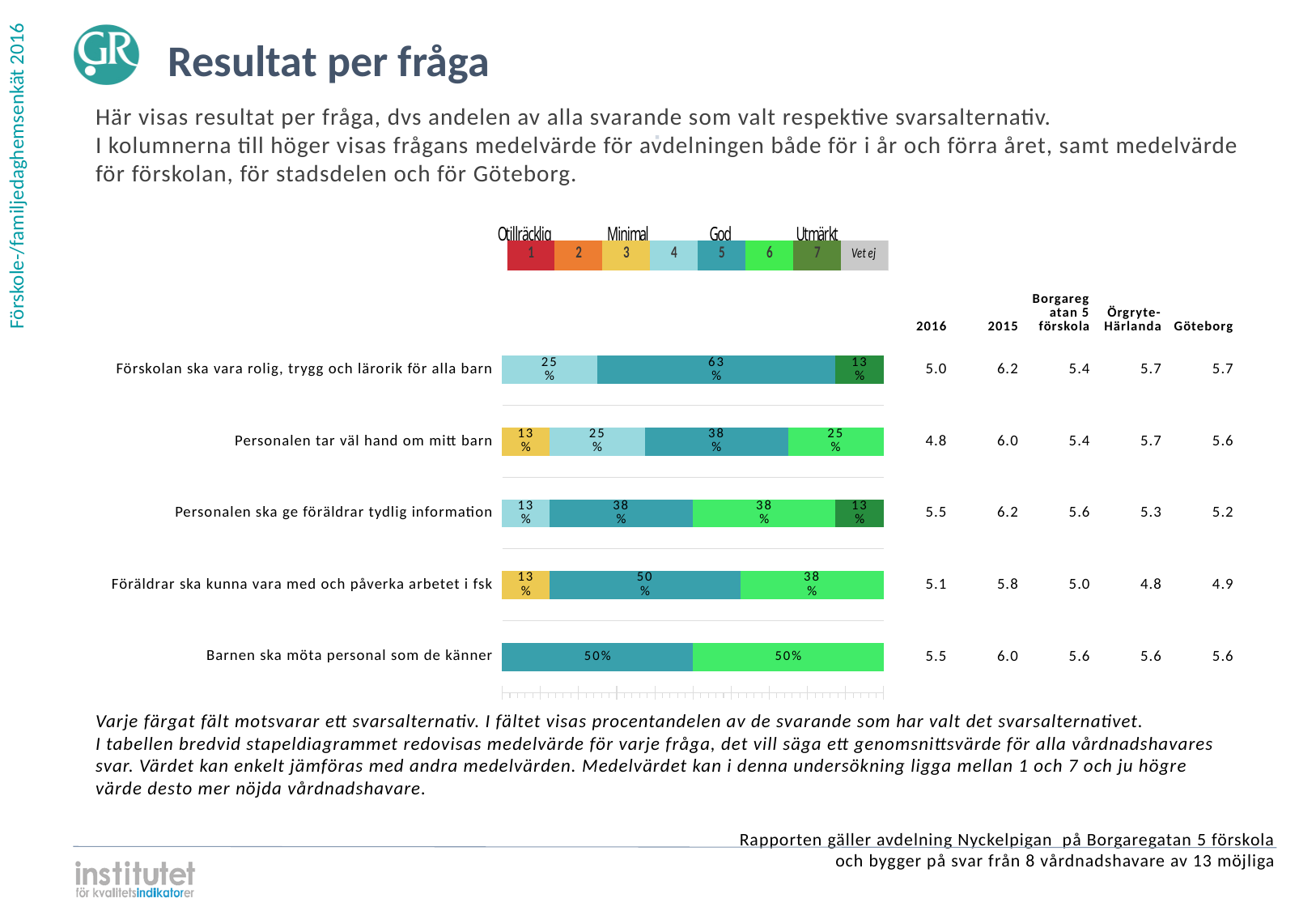
What share of respondents chose rating 3 for 'Personalen tar väl hand om mitt barn'? 13% What share of respondents chose rating 5 for 'Barnen ska möta personal som de känner'? 50% Which rating in the legend is shown in red? 1 How many questions (categories) are plotted in the bar chart? 5 What share of respondents chose rating 5 (God) for 'Förskolan ska vara rolig, trygg och lärorik för alla barn'? 63% How many answer alternatives does the legend above the chart list? 8 For 'Personalen tar väl hand om mitt barn', which is larger: the share for rating 5 or the share for rating 6? Rating 5 What share of respondents chose rating 6 for 'Föräldrar ska kunna vara med och påverka arbetet i fsk'? 38% For 'Personalen ska ge föräldrar tydlig information', what is the difference between the share for rating 5 and the share for rating 7? 25% Which question has the largest single segment in the bar chart? Förskolan ska vara rolig, trygg och lärorik för alla barn What is the combined share of ratings 5 and 6 for 'Barnen ska möta personal som de känner'? 100% What kind of chart is shown on the slide? Stacked bar chart